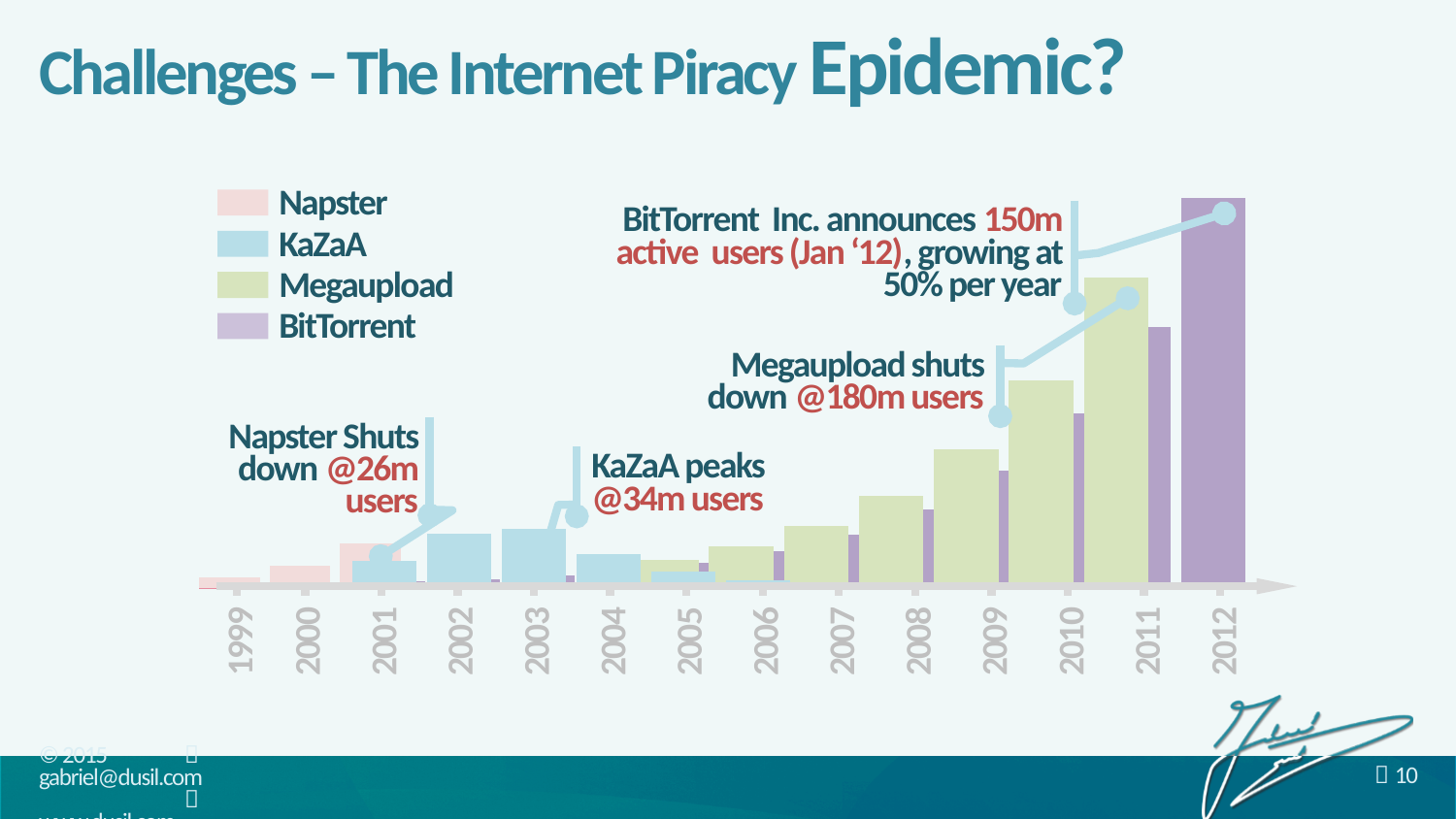
At how many users did Napster shut down, according to the annotation? 26m users Which series has the tallest bar on the chart? BitTorrent At how many users did Megaupload shut down, according to the annotation? 180m users Do the Megaupload bars rise or fall from 2005 to 2011? rise How many series does the legend list? 4 Which colour represents BitTorrent in the legend? purple How many years are shown along the x axis? 14 Which is taller: the KaZaA bar for 2002 or the KaZaA bar for 2004? 2002 What kind of chart is shown on the slide? bar chart At how many users did KaZaA peak, according to the annotation? 34m users In which year does the tallest bar on the chart appear? 2012 How many active users did BitTorrent Inc. announce in Jan '12? 150m